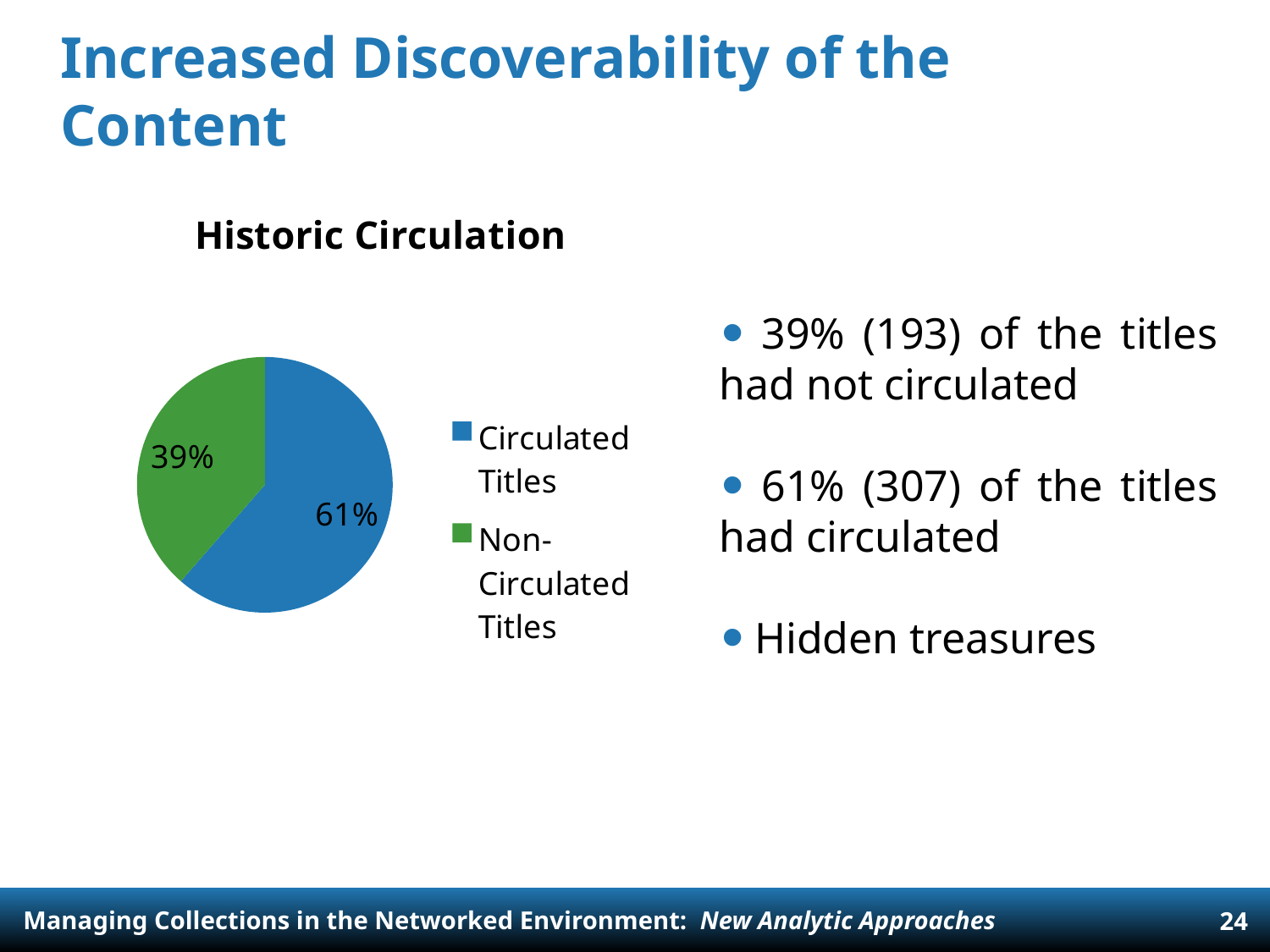
What kind of chart is shown on the slide? pie chart What percentage of the pie is Non-Circulated Titles? 39% What is the difference in percentage points between Circulated Titles and Non-Circulated Titles? 22 Is the share for Circulated Titles greater or less than 50%? greater What is the title of the chart? Historic Circulation Which slice of the pie is the smallest? Non-Circulated Titles How many entries does the legend list? 2 What percentage of the pie is Circulated Titles? 61% How many slices does the pie chart have? 2 Which slice of the pie is the largest? Circulated Titles Which is larger, the share for Circulated Titles or the share for Non-Circulated Titles? Circulated Titles What colour is the Non-Circulated Titles slice? green